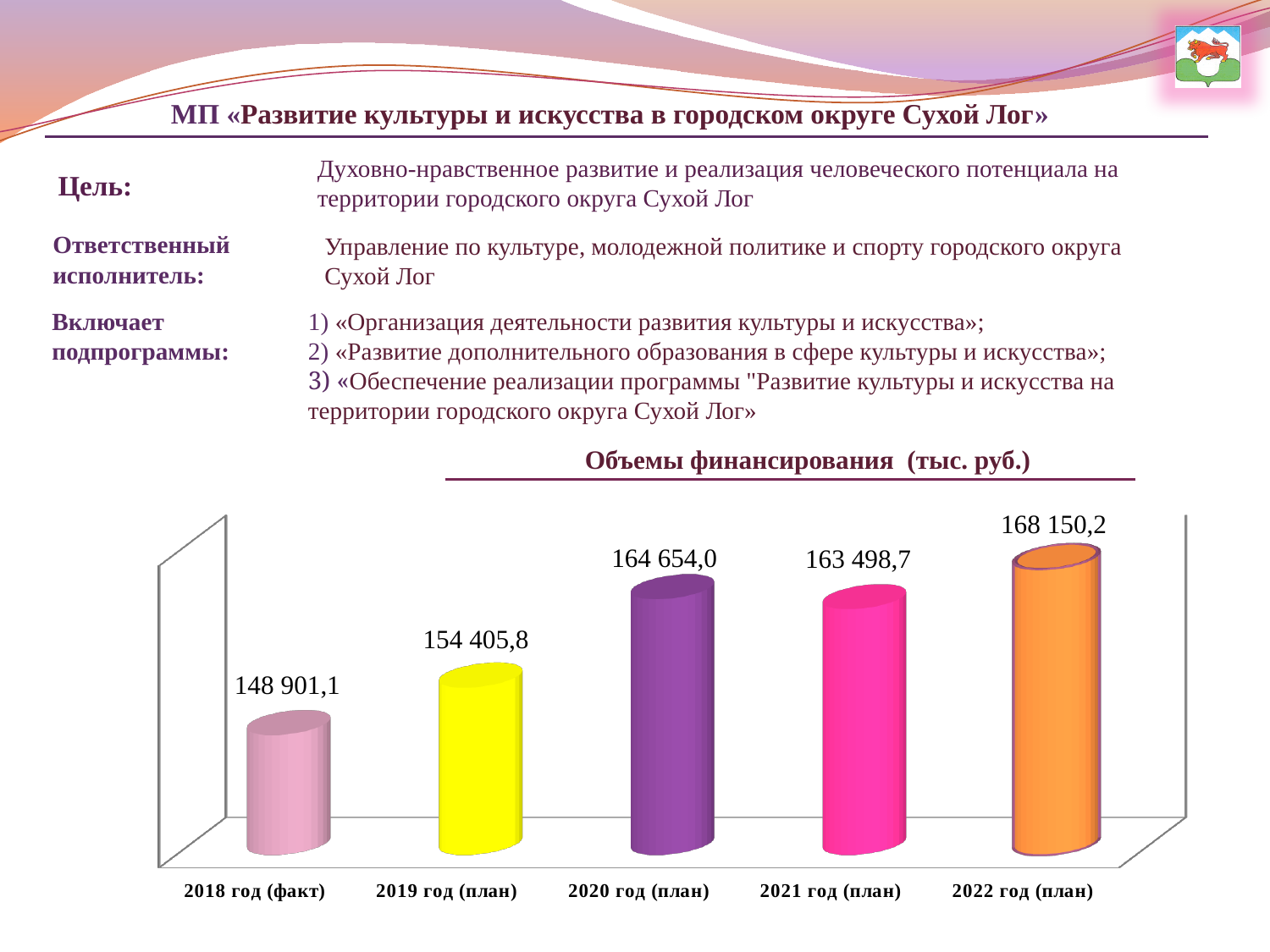
What is the difference between the values for 2020 год (план) and 2021 год (план)? 1 155,3 What is the difference between the values for 2022 год (план) and 2018 год (факт)? 19 249,1 What is the value for 2020 год (план)? 164 654,0 Which year has the lowest financing volume? 2018 год (факт) What kind of chart is shown on the slide? Bar chart Which is larger, the value for 2020 год (план) or 2021 год (план)? 2020 год (план) What is the value for 2018 год (факт) in the chart 'Объемы финансирования (тыс. руб.)'? 148 901,1 Which year has the highest financing volume? 2022 год (план) What is the value for 2019 год (план)? 154 405,8 What is the value for 2021 год (план)? 163 498,7 How many years are shown in the chart? 5 What is the value for 2022 год (план)? 168 150,2